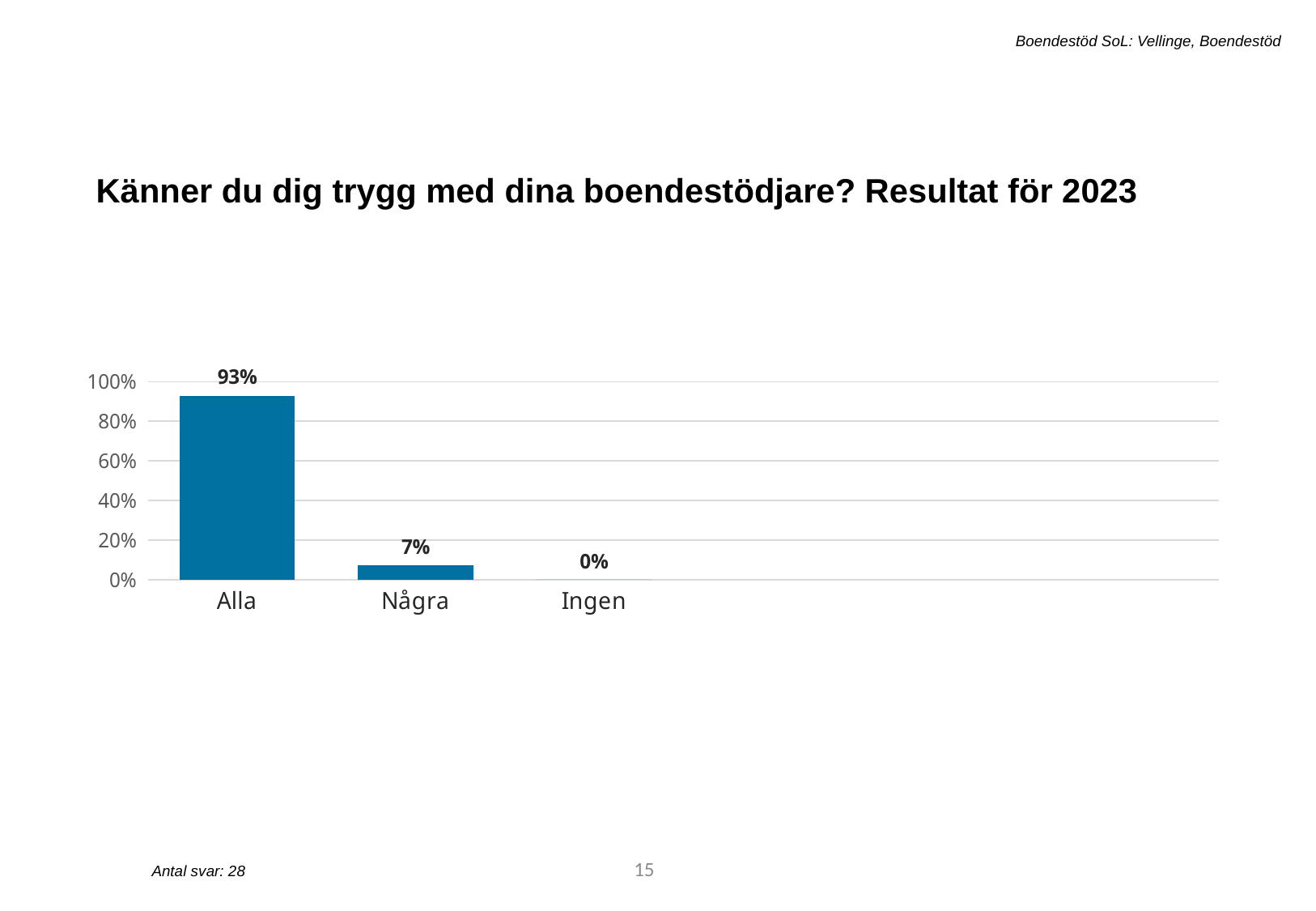
Which category has the lowest value? Ingen How many categories are shown on the x axis? 3 Which category has the highest value? Alla Which is larger, the value for Några or the value for Ingen? Några What is the title of the slide? Känner du dig trygg med dina boendestödjare? Resultat för 2023 Do the values rise or fall from left to right along the x axis? fall What is the difference between the values for Alla and Några? 86% What is the value for Några? 7% What is the value for Alla? 93% What is the value for Ingen? 0% What kind of chart is shown on the slide? bar chart Is the value for Alla greater or less than 80%? greater